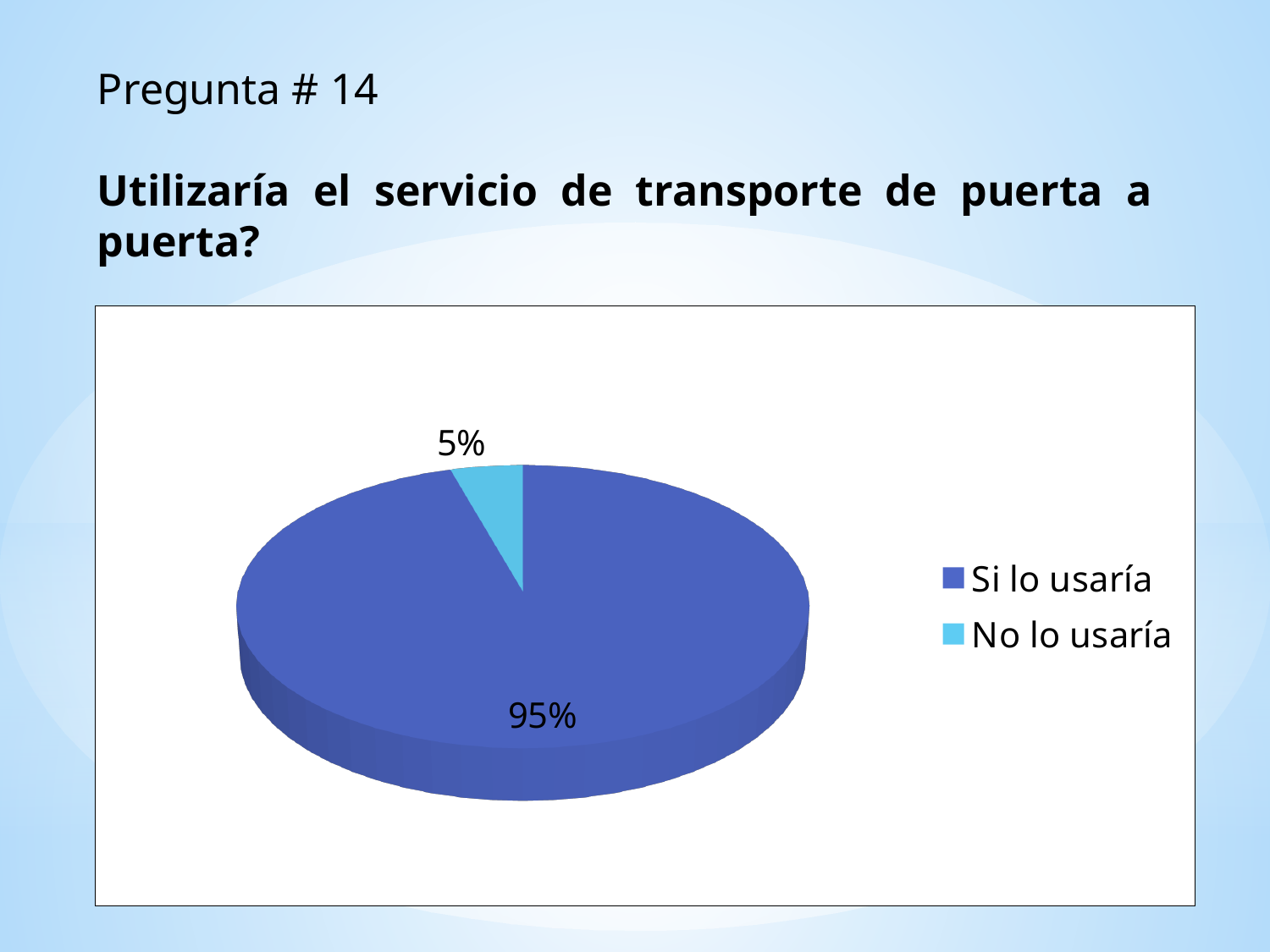
How many categories does the pie chart show? 2 What kind of chart is shown on the slide? pie chart What colour is the slice for "No lo usaría"? light blue What question is the chart on the slide answering? Utilizaría el servicio de transporte de puerta a puerta? Which is larger, the share for "Si lo usaría" or the share for "No lo usaría"? Si lo usaría How many entries does the legend list? 2 Which category has the largest share of the pie? Si lo usaría Which category has the smallest share of the pie? No lo usaría What is the difference in percentage points between "Si lo usaría" and "No lo usaría"? 90 What percentage of the pie corresponds to "Si lo usaría"? 95% What percentage of the pie corresponds to "No lo usaría"? 5%